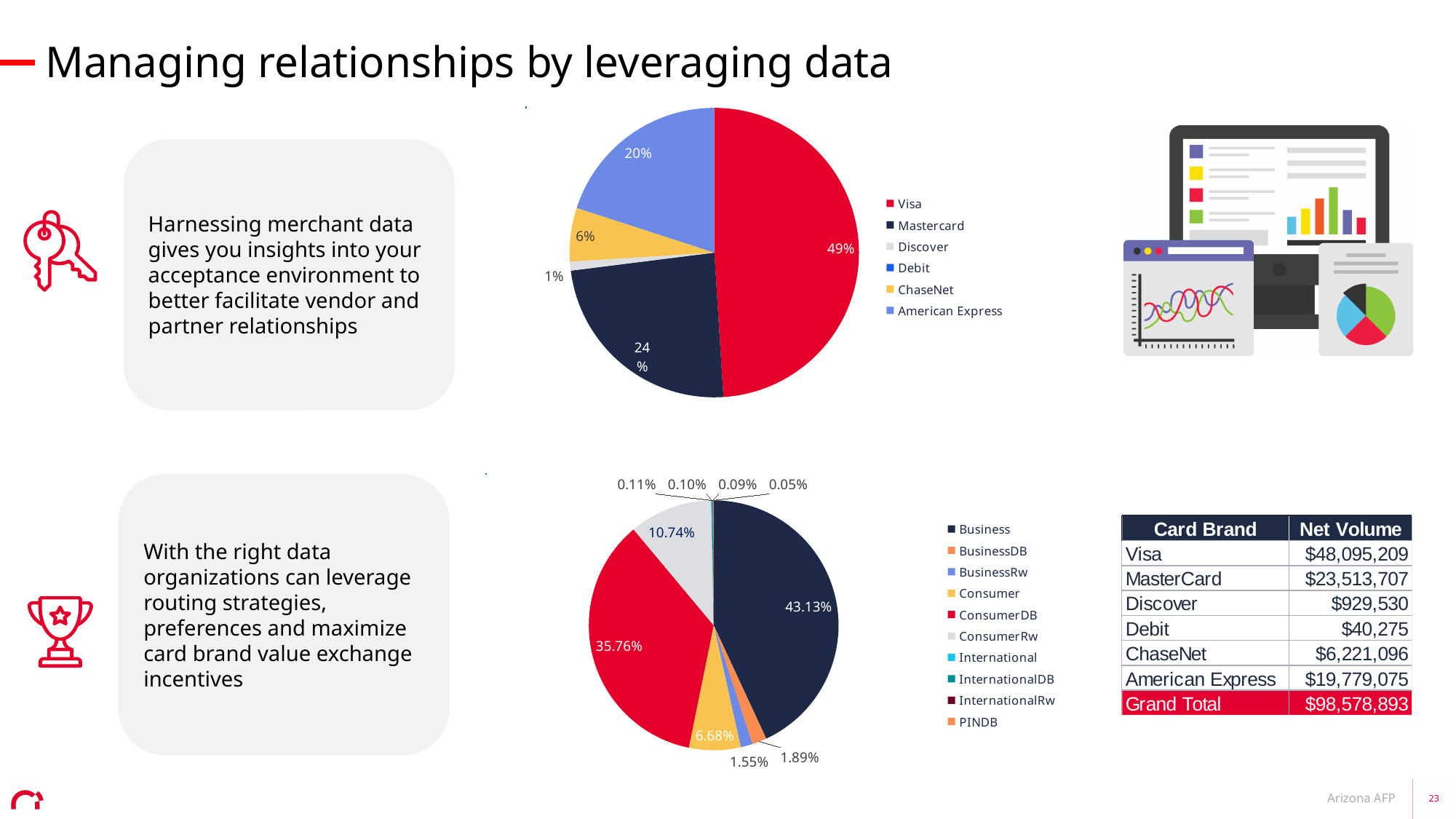
On the bottom pie chart, what share does Business have? 43.13% On the top pie chart, how many entries does the legend list? 6 On the top pie chart, what share does Visa have? 49% On the bottom pie chart, how many entries does the legend list? 10 On the top pie chart, what share does American Express have? 20% On the bottom pie chart, what is the difference between the Business share and the ConsumerDB share? 7.37% On the top pie chart, which is larger, ChaseNet or American Express? American Express On the bottom pie chart, which category has the largest slice? Business On the bottom pie chart, what share does ConsumerDB have? 35.76% What type of chart is the bottom chart? Pie chart On the top pie chart, what is the difference between the Visa share and the Mastercard share? 25% On the top pie chart, which card brand has the largest slice? Visa